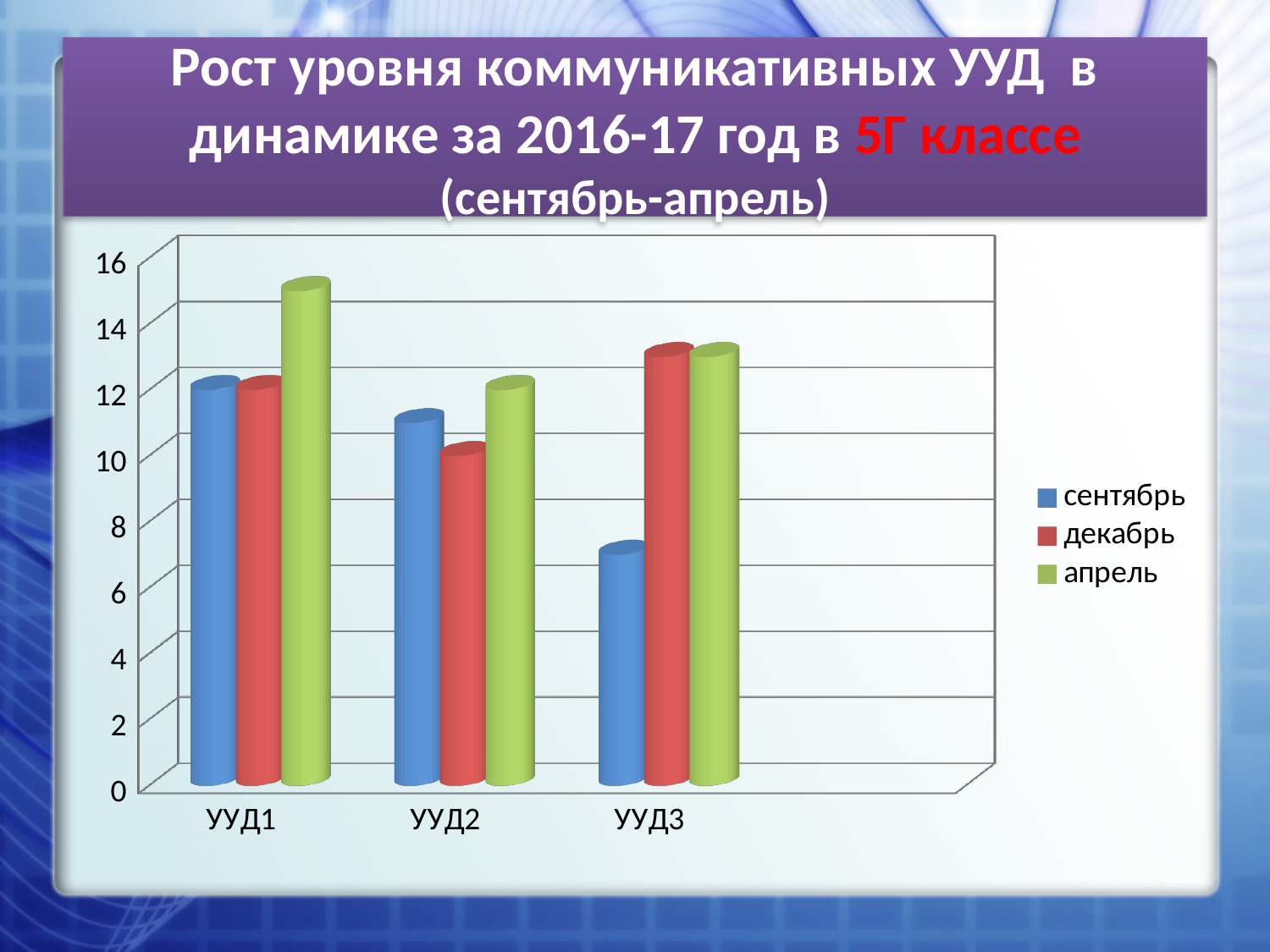
For УУД3, which is larger: the сентябрь value or the декабрь value? декабрь Which category has the lowest сентябрь value? УУД3 Is the апрель value for УУД1 greater or less than 14? greater What kind of chart is shown on the slide? bar chart Is the декабрь value for УУД2 greater or less than 12? less Which series are listed in the chart legend? сентябрь, декабрь, апрель How many series does the chart legend list? 3 How many categories are shown on the x axis of the chart? 3 Which category has the highest апрель value? УУД1 Which colour represents the апрель series in the chart? green Is the сентябрь value for УУД1 greater or less than 10? greater